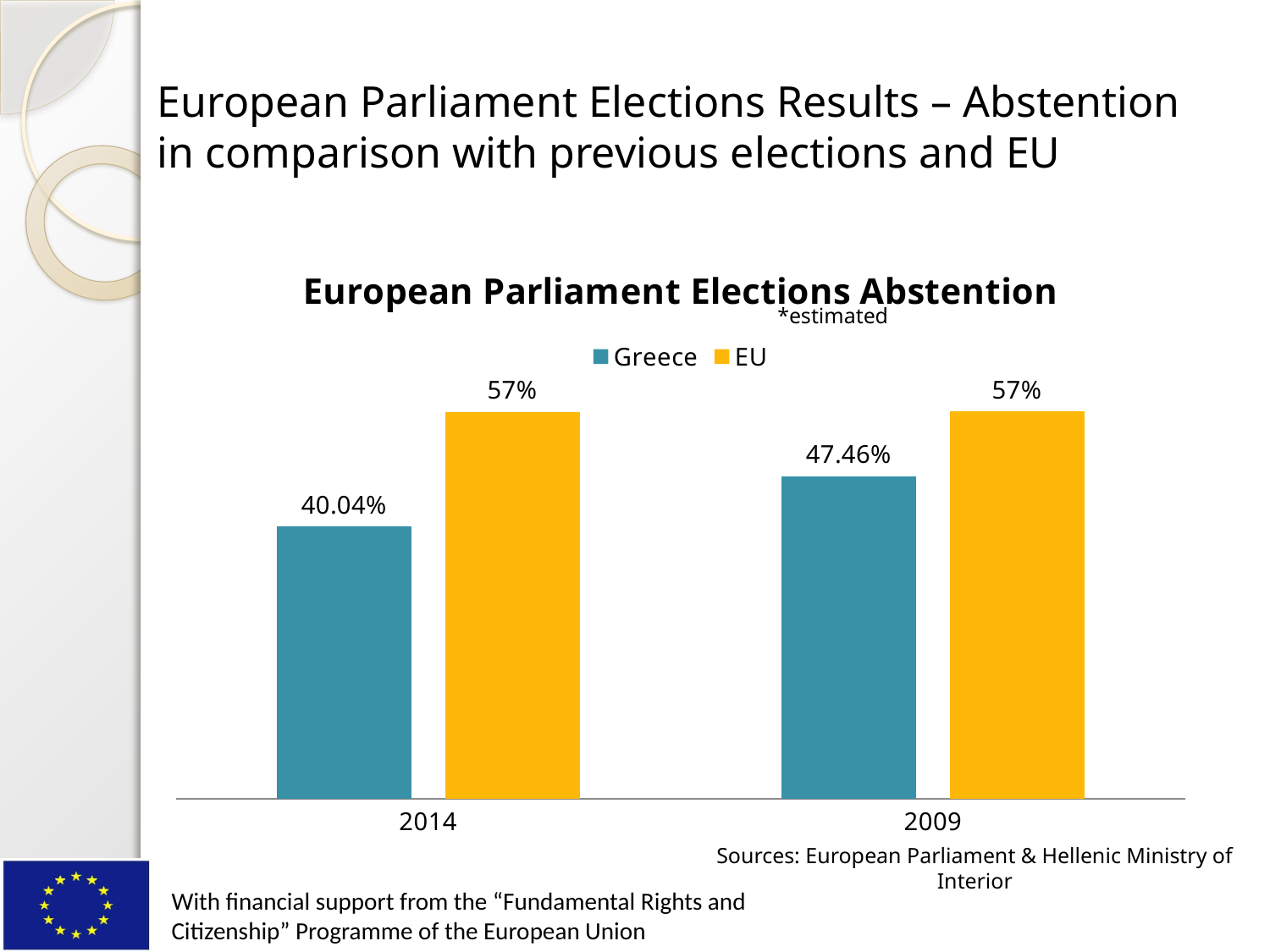
What is the difference between the EU and Greece abstention values in 2009? 9.54% Which series has the lowest value shown on the chart, and in which year? Greece, 2014 What kind of chart is shown on the slide? Bar chart Which is larger for Greece, the 2014 value or the 2009 value? 2009 What is the difference between the EU and Greece abstention values in 2014? 16.96% What is the abstention value for the EU in 2009? 57% Which is larger in 2009, the Greece value or the EU value? EU What is the abstention value for the EU in 2014? 57% How many years (categories) are shown on the x axis? 2 What is the abstention value for Greece in 2009? 47.46% What is the abstention value for Greece in 2014? 40.04% How many series does the legend list? 2